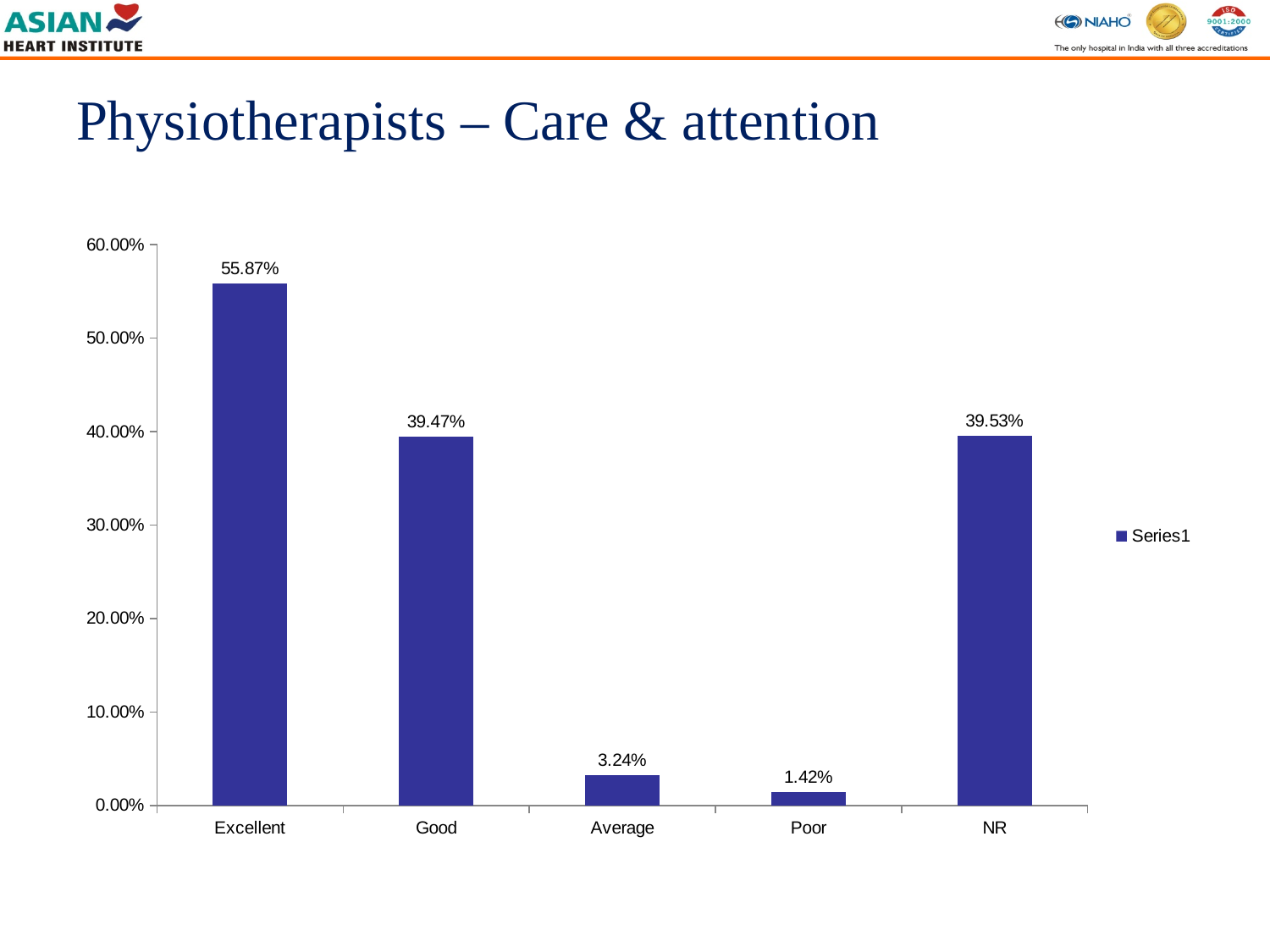
What is the value for Excellent? 55.87% What is the difference between the values for Excellent and Good? 16.40% Which category has the highest value? Excellent What is the title of the slide? Physiotherapists – Care & attention What is the value for Good? 39.47% How many categories are shown on the x axis? 5 What is the value for Average? 3.24% What kind of chart is shown on the slide? Bar chart What is the value for Poor? 1.42% What is the value for NR? 39.53% Which is larger, the value for Average or the value for Poor? Average Which category has the lowest value? Poor